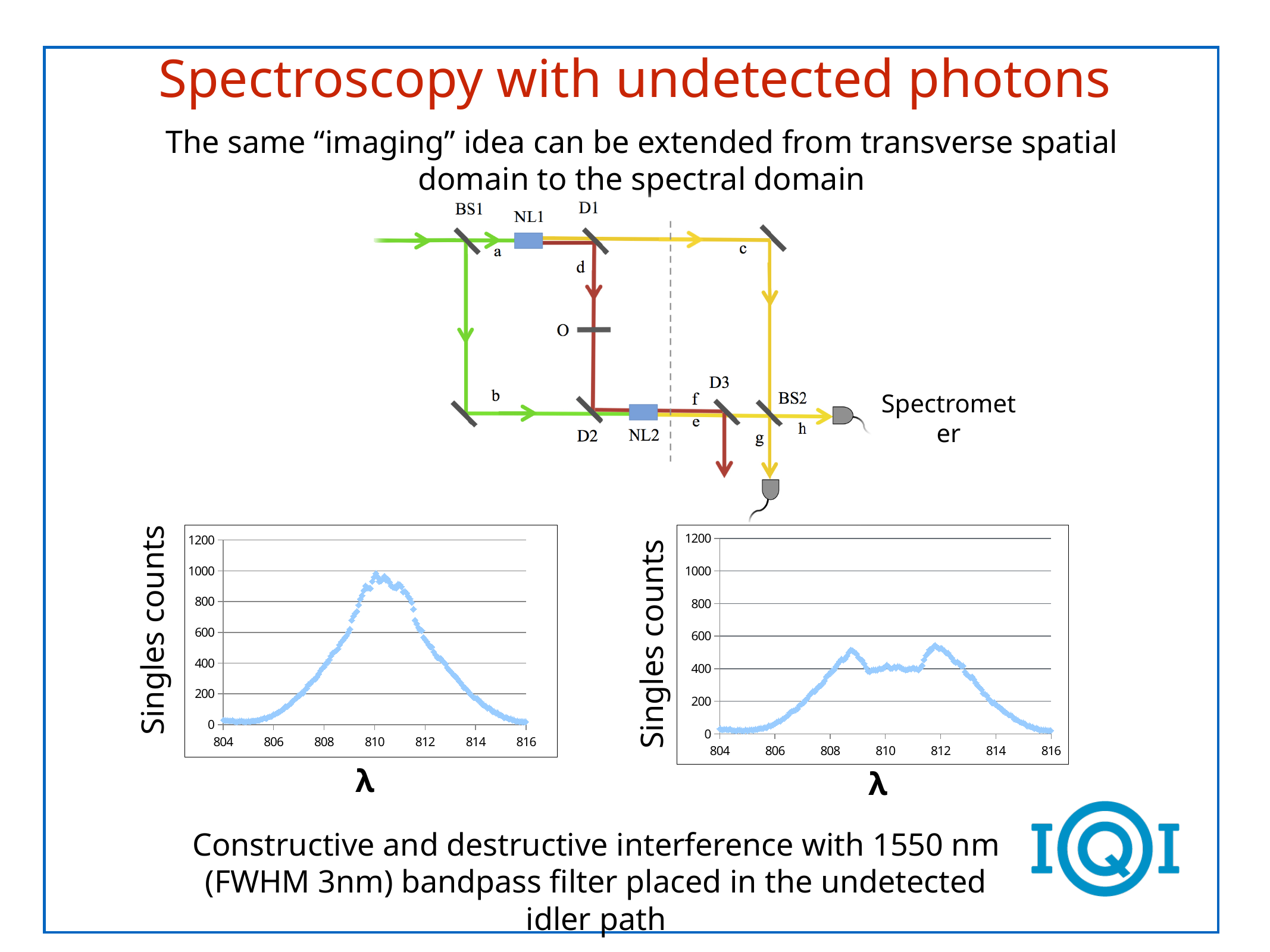
In the right chart, is the value at 812 greater or less than 400? greater What is the highest tick value shown on the y-axis of the right chart? 1200 In the left chart, is the peak value greater or less than 800? greater What is the y-axis label of the left chart? Singles counts In the right chart, is the highest value greater or less than 600? less What kind of chart is the left chart? scatter chart Which chart reaches a higher peak in singles counts, the left chart or the right chart? the left chart In the left chart, do the values rise or fall as the wavelength goes from 804 to 810? rise In the left chart, do the values rise or fall as the wavelength goes from 810 to 816? fall